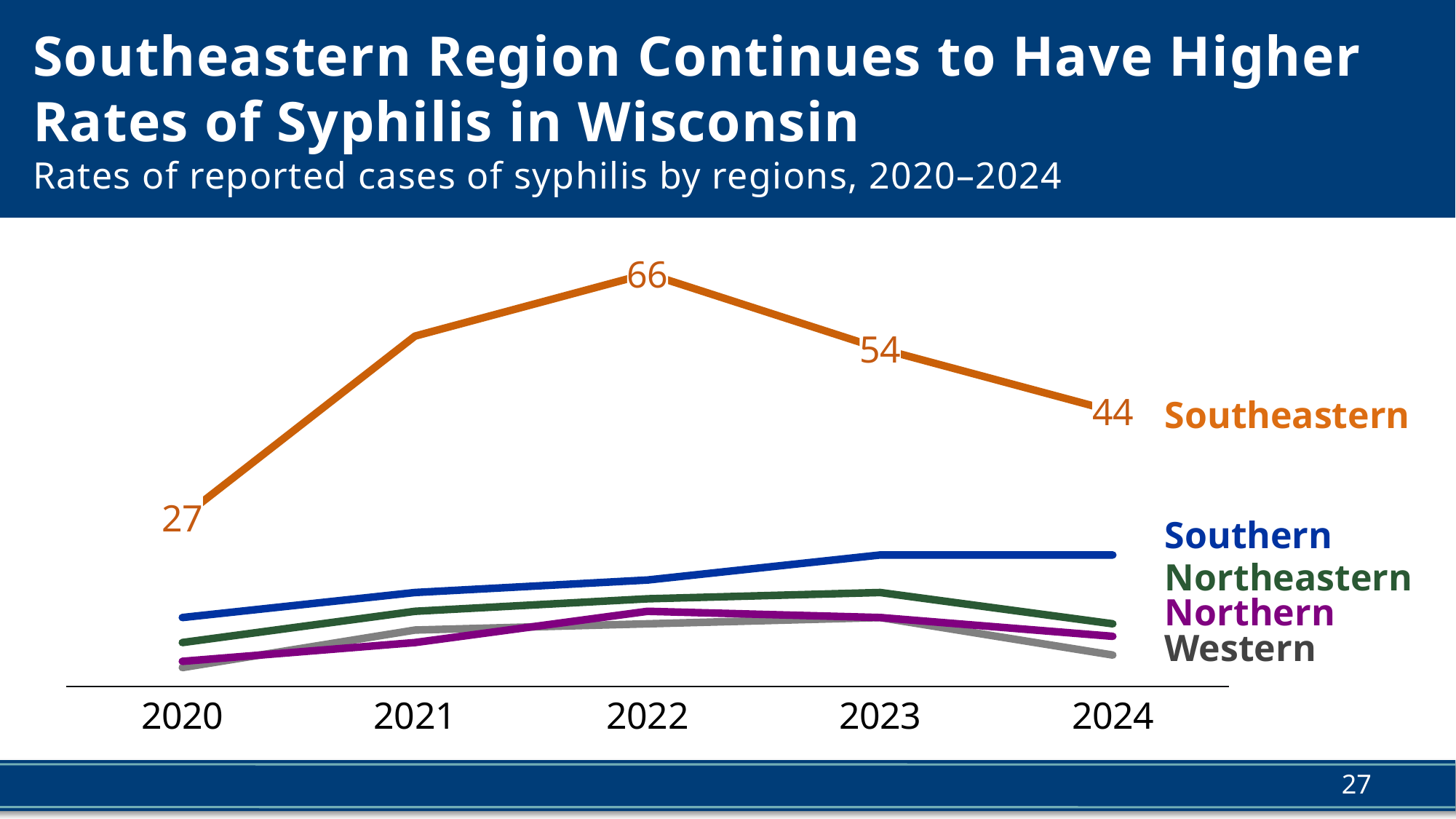
What was the Southeastern region's syphilis rate in 2023? 54 Did the Southeastern region's rate rise or fall between 2022 and 2024? fall In which year was the Southeastern region's syphilis rate lowest? 2020 In which year did the Southeastern region reach its highest syphilis rate? 2022 What type of chart is shown on the slide? line chart Which region had a higher rate in 2024, Southern or Western? Southern By how much did the Southeastern region's rate fall from 2022 to 2024? 22 Which region had the highest syphilis rate in 2024? Southeastern What was the Southeastern region's syphilis rate in 2020? 27 What was the Southeastern region's syphilis rate in 2024? 44 How many regions are plotted on the chart? 5 What was the Southeastern region's syphilis rate in 2022? 66